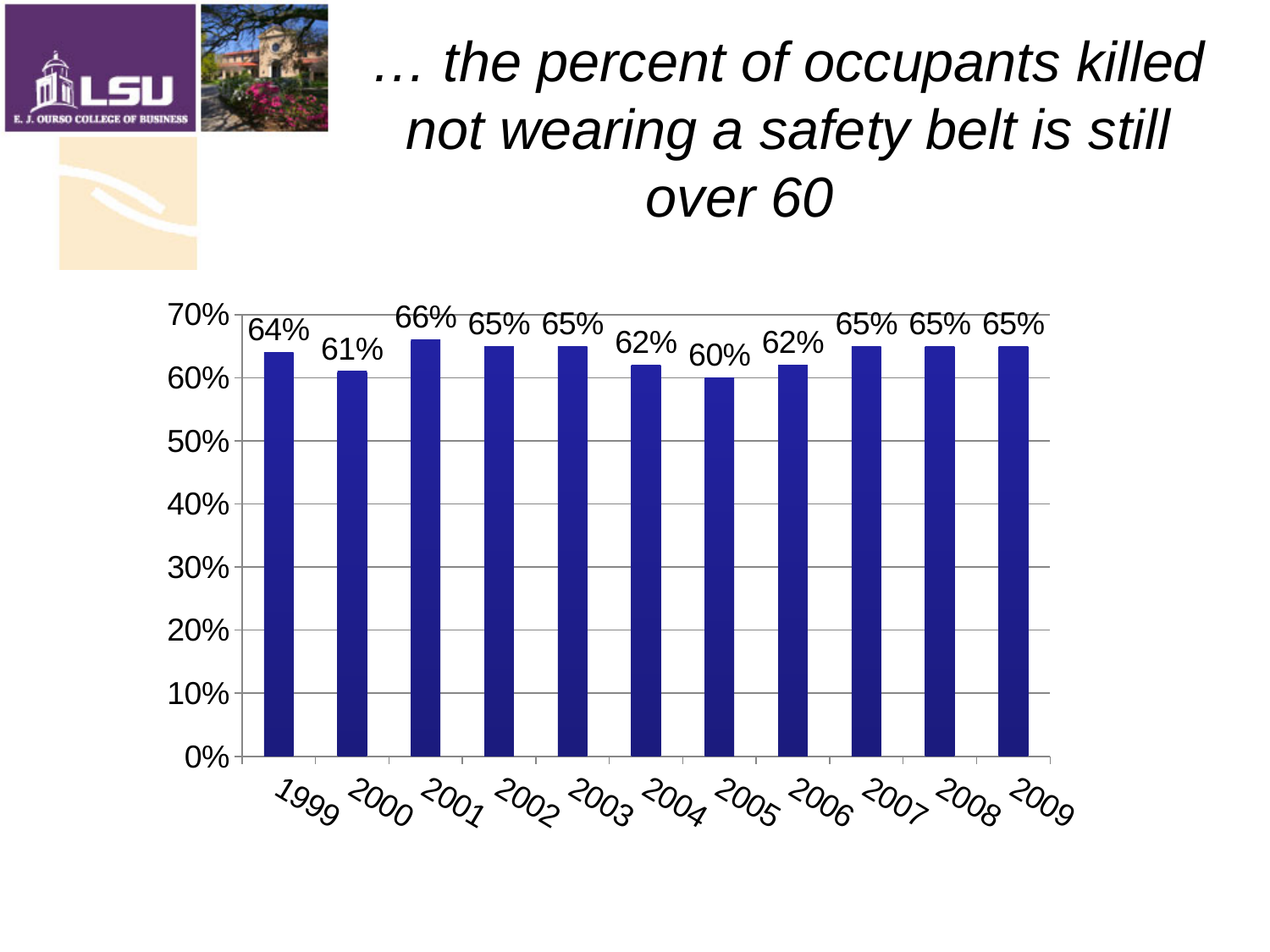
Which year has the lowest value? 2005 What is the difference between the values for 1999 and 2000? 3% Which is larger, the value for 2000 or the value for 2004? 2004 What is the value for 2005? 60% Is the value for 2006 greater or less than 50%? greater What is the value for 2008? 65% What is the difference between the values for 2001 and 2005? 6% How many years are shown on the x axis? 11 What is the value for 1999? 64% What is the value for 2001? 66% What kind of chart is shown on the slide? bar chart Which year has the highest value? 2001